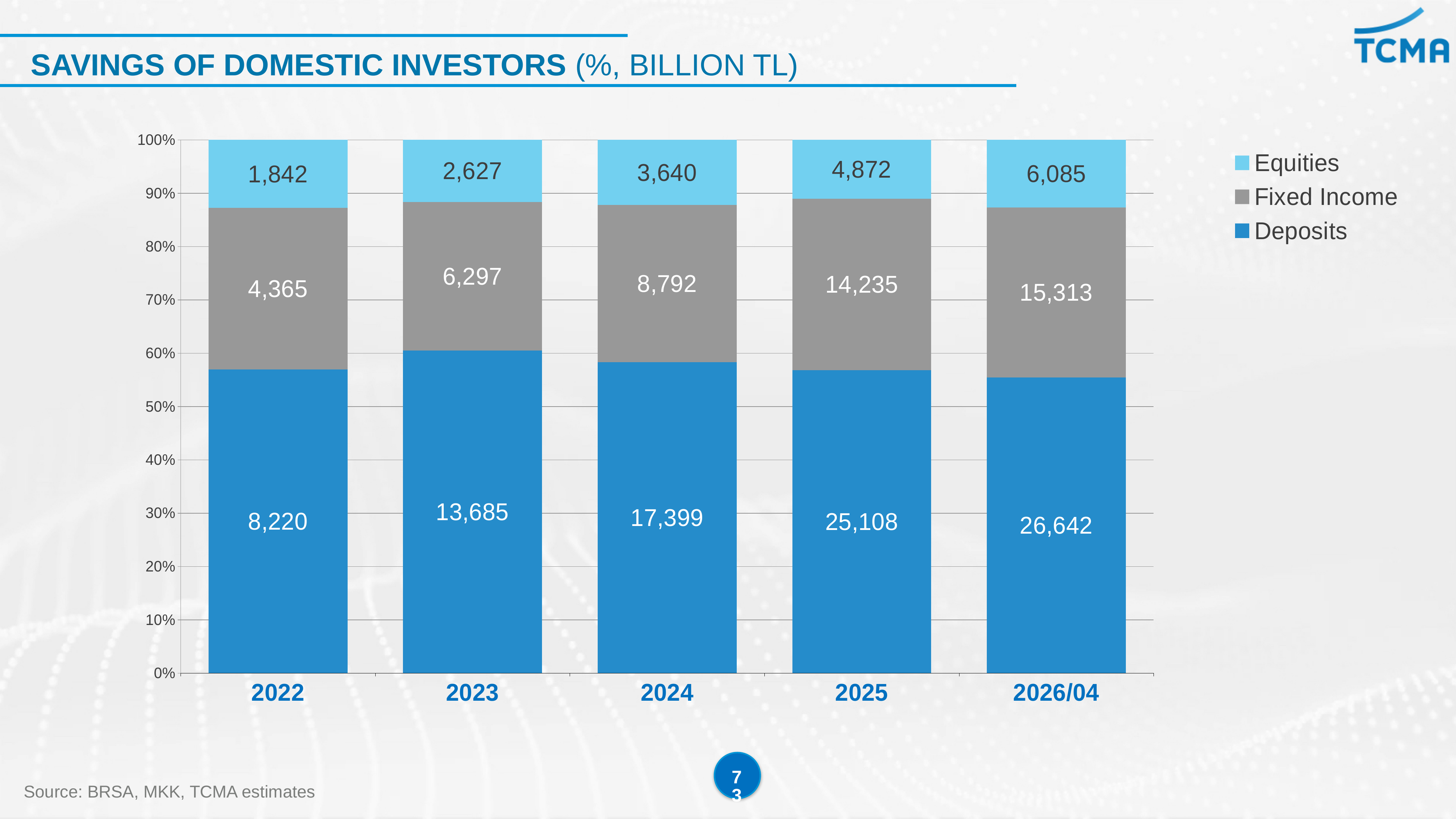
What kind of chart is shown on the slide? Stacked bar chart How many series does the legend list? 3 Is the Deposits share of the 2026/04 bar greater or less than 60%? less In which year is the Deposits value highest? 2026/04 What is the Equities value for 2025? 4,872 What is the Fixed Income value for 2024? 8,792 In which year is the Equities value lowest? 2022 How many years are shown on the x axis? 5 Which is larger in 2023, Fixed Income or Equities? Fixed Income What is the total of the three values labelled on the 2022 bar? 14,427 What is the Deposits value for 2022? 8,220 What is the difference between the Deposits values for 2023 and 2022? 5,465